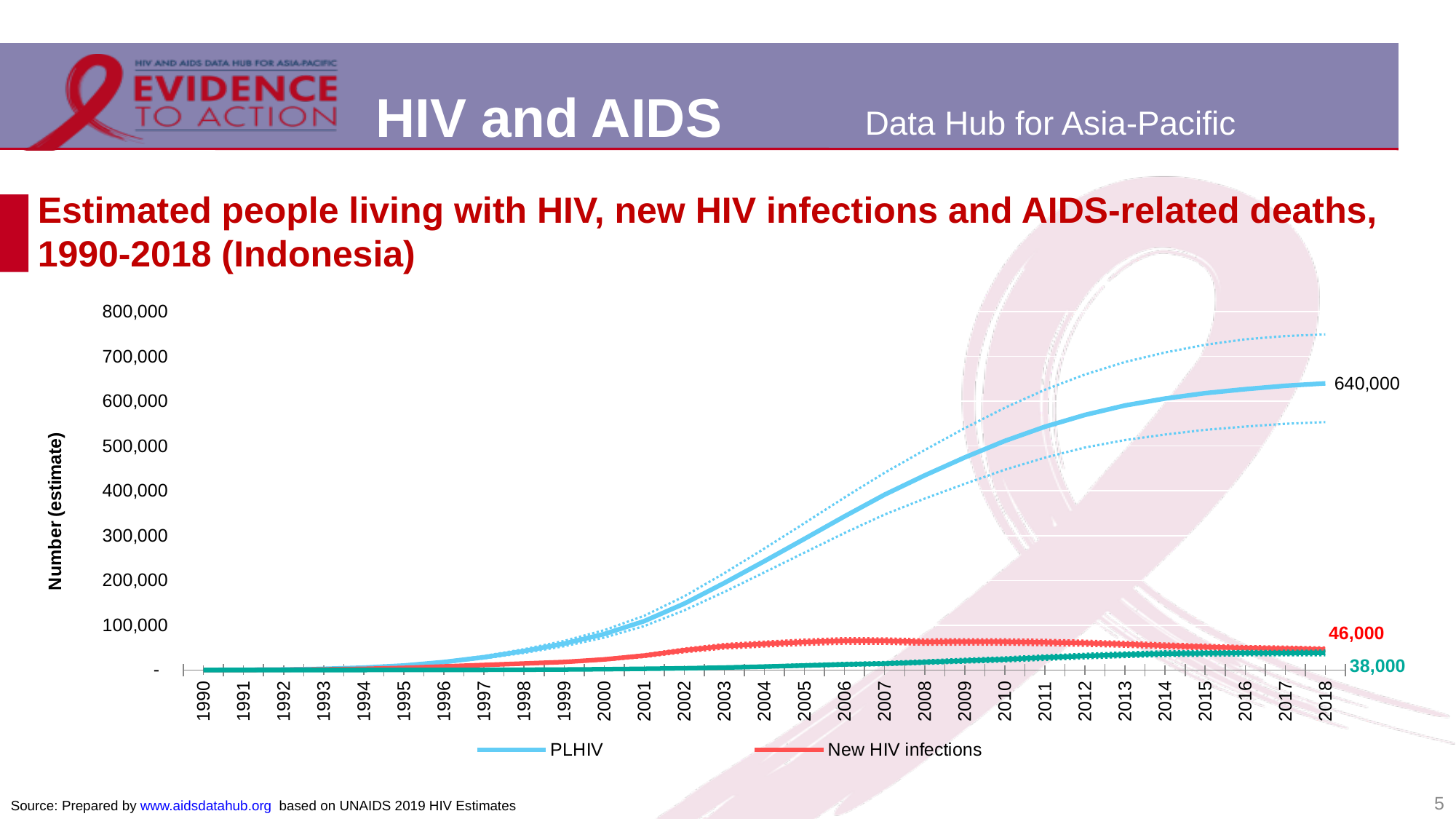
What kind of chart is shown on the slide? line chart What is the estimated number of PLHIV in 2018? 640,000 Which is larger in 2018, PLHIV or New HIV infections? PLHIV How many series does the legend list? 2 What is the difference between the PLHIV value and the New HIV infections value in 2018? 594,000 Is the PLHIV value in 2005 greater or less than 200,000? greater What value is labelled at the end of the green line in 2018? 38,000 What is the difference between the New HIV infections value (46,000) and the green line value (38,000) in 2018? 8,000 What is the value for New HIV infections in 2018? 46,000 Which series has the highest value in 2018? PLHIV Does the PLHIV line rise or fall from 1990 to 2018? rise Is the PLHIV value in 2000 greater or less than 100,000? less